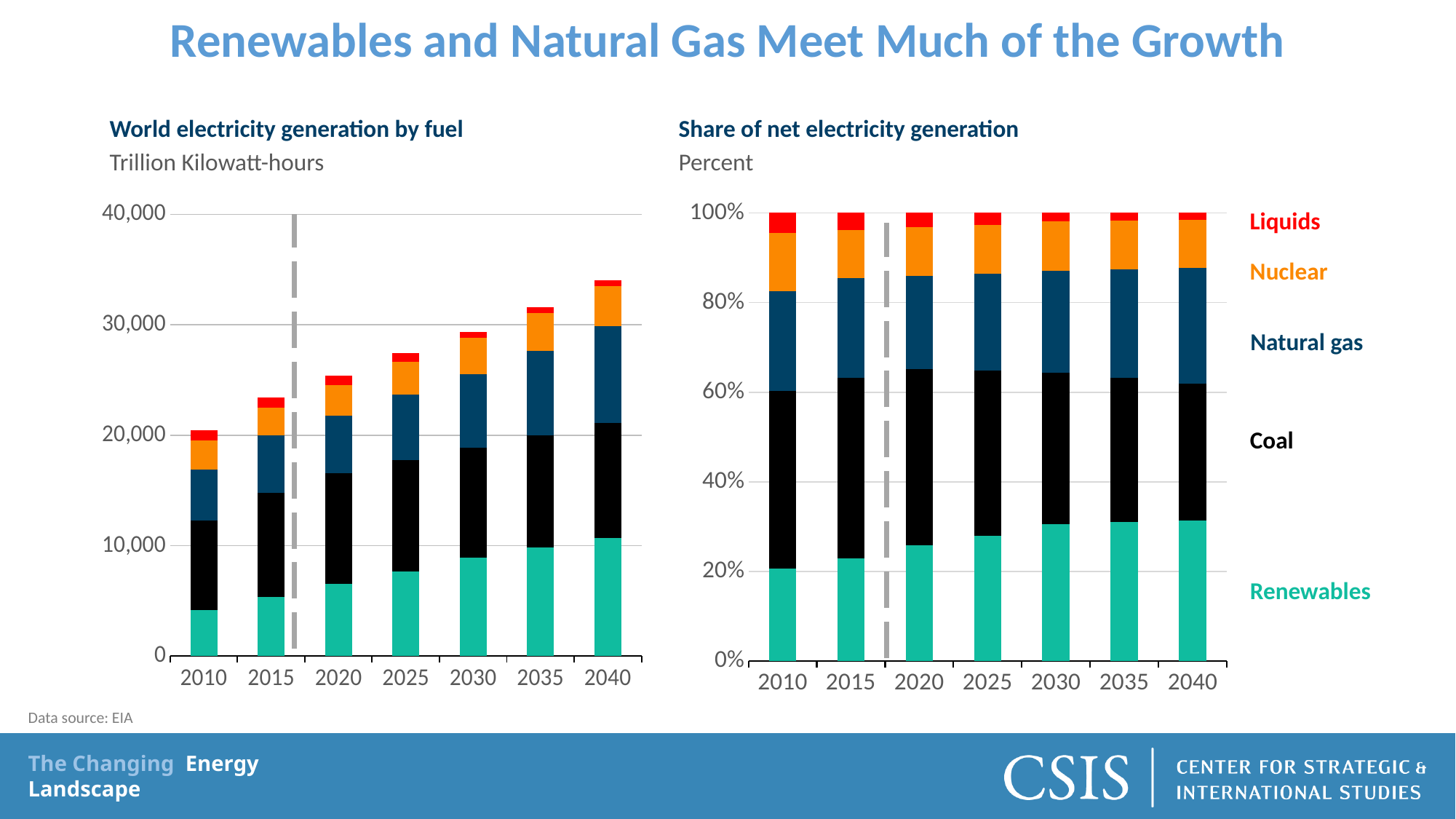
How many years are shown on the x axis of the 'Share of net electricity generation' chart? 7 In the 'World electricity generation by fuel' chart, is the total for 2020 greater or less than 20,000? greater In the 'Share of net electricity generation' chart, is the Renewables share in 2040 greater or less than 20%? greater How many fuel series does the legend of the 'Share of net electricity generation' chart list? 5 In the 'World electricity generation by fuel' chart, which year has the highest total generation? 2040 In the 'Share of net electricity generation' chart, what is the total height of each stacked bar? 100% What unit is given under the title of the left chart? Trillion Kilowatt-hours In the 'World electricity generation by fuel' chart, which is larger: the total for 2035 or the total for 2015? 2035 What kind of chart is the 'World electricity generation by fuel' chart? stacked bar chart In the 'World electricity generation by fuel' chart, which year has the lowest total generation? 2010 In the 'World electricity generation by fuel' chart, does total generation rise or fall from 2010 to 2040? rise In the 'World electricity generation by fuel' chart, is the total for 2040 greater or less than 30,000? greater